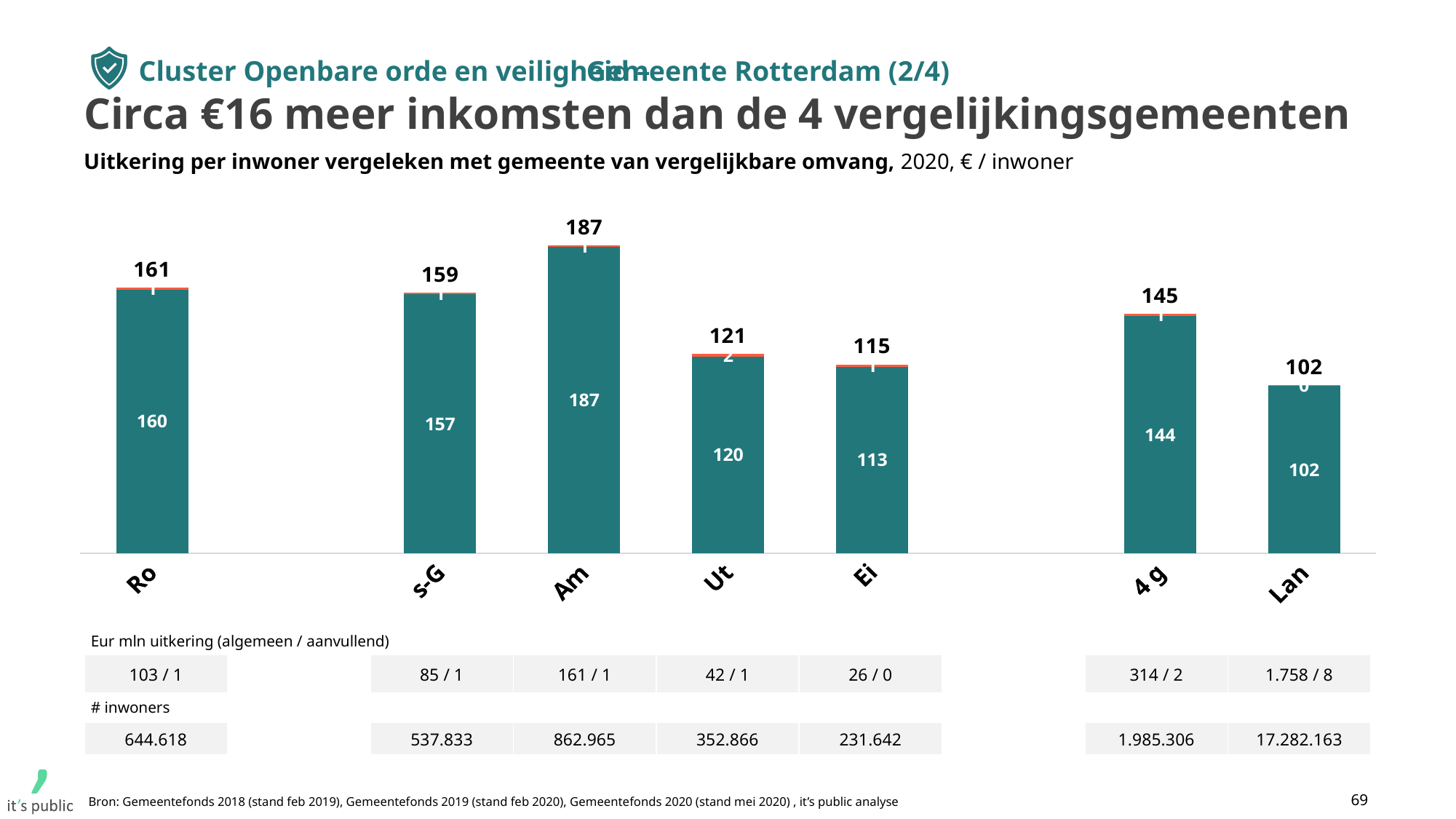
What is the difference between the total for Am and the total for Ro? 26 Which category has the lowest total value? Lan What is the value of the teal (algemeen) segment for Ei? 113 Which has a larger total value, Ut or Ei? Ut What is the number of inhabitants (# inwoners) listed for Am? 862.965 What kind of chart is shown on the slide? Stacked bar chart What is the total value shown above the bar for Am? 187 Which category has the highest total value? Am What is the value of the teal (algemeen) segment for s-G? 157 How many categories (bars) are shown in the chart? 7 What is the difference between the total for Ro and the total for 4 g? 16 What is the total value shown above the bar for Ro? 161